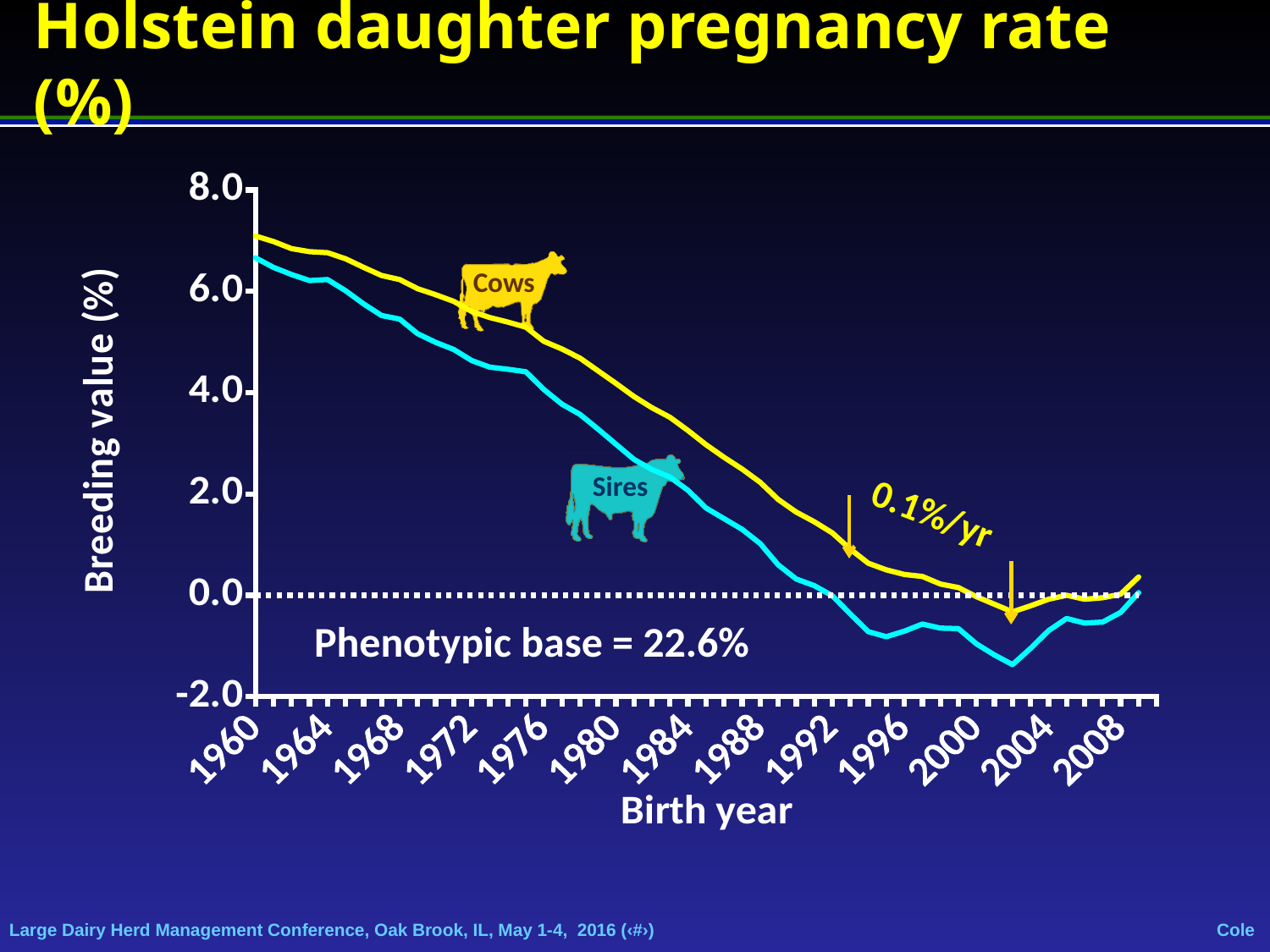
What is the label of the y axis? Breeding value (%) What are the names of the two series plotted on the chart? Cows and Sires Do the breeding values for Cows rise or fall from 1960 to 2004? fall In 1980, which series has the higher breeding value, Cows or Sires? Cows Do the breeding values for Sires rise or fall from 1960 to 2004? fall Which series has the lower breeding value in 2000, Cows or Sires? Sires Is the value for Cows in 1976 greater or less than 4.0? greater Is the value for Sires in 2004 greater or less than 0.0? less What kind of chart is shown on the slide? line chart Is the value for Sires in 1988 greater or less than 2.0? less How many series are plotted on the chart? 2